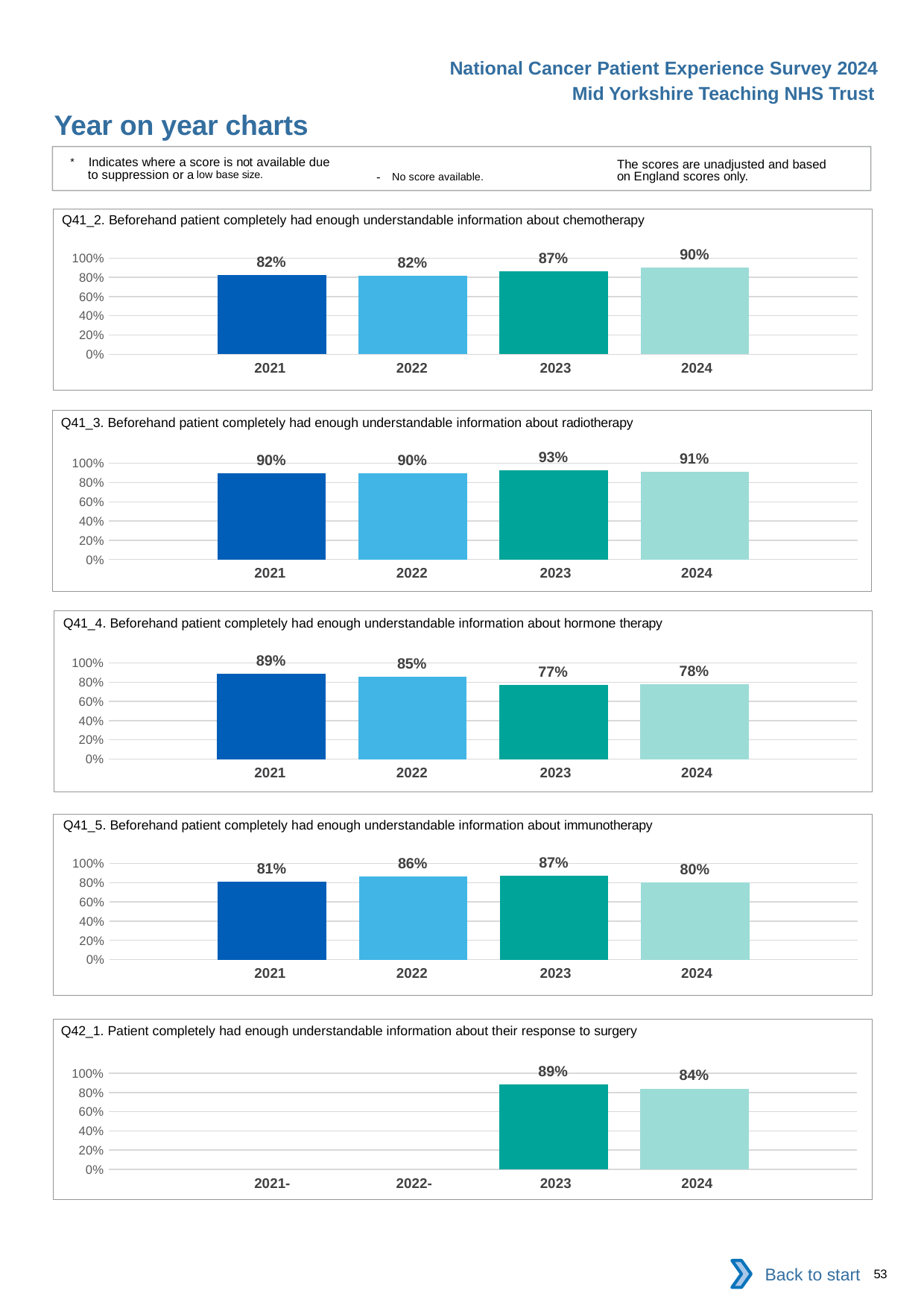
In the Q42_1 chart (response to surgery), what is the value for 2024? 84% In the Q41_2 chart (chemotherapy), what is the value for 2024? 90% In the Q41_5 chart (immunotherapy), what is the value for 2021? 81% In the Q41_5 chart (immunotherapy), which is larger, the value for 2022 or the value for 2024? 2022 In the Q41_3 chart (radiotherapy), which year has the highest value? 2023 In the Q41_4 chart (hormone therapy), which year has the lowest value? 2023 In the Q41_3 chart (radiotherapy), what is the value for 2022? 90% In the Q41_4 chart (hormone therapy), do the values generally rise or fall from 2021 to 2024? Fall In the Q41_2 chart (chemotherapy), what is the difference between the 2023 and 2021 values? 5% In the Q42_1 chart (response to surgery), how many years have a bar plotted? 2 What kind of chart is the Q41_2 chart (chemotherapy)? Bar chart In the Q41_4 chart (hormone therapy), what is the difference between the 2021 and 2024 values? 11%